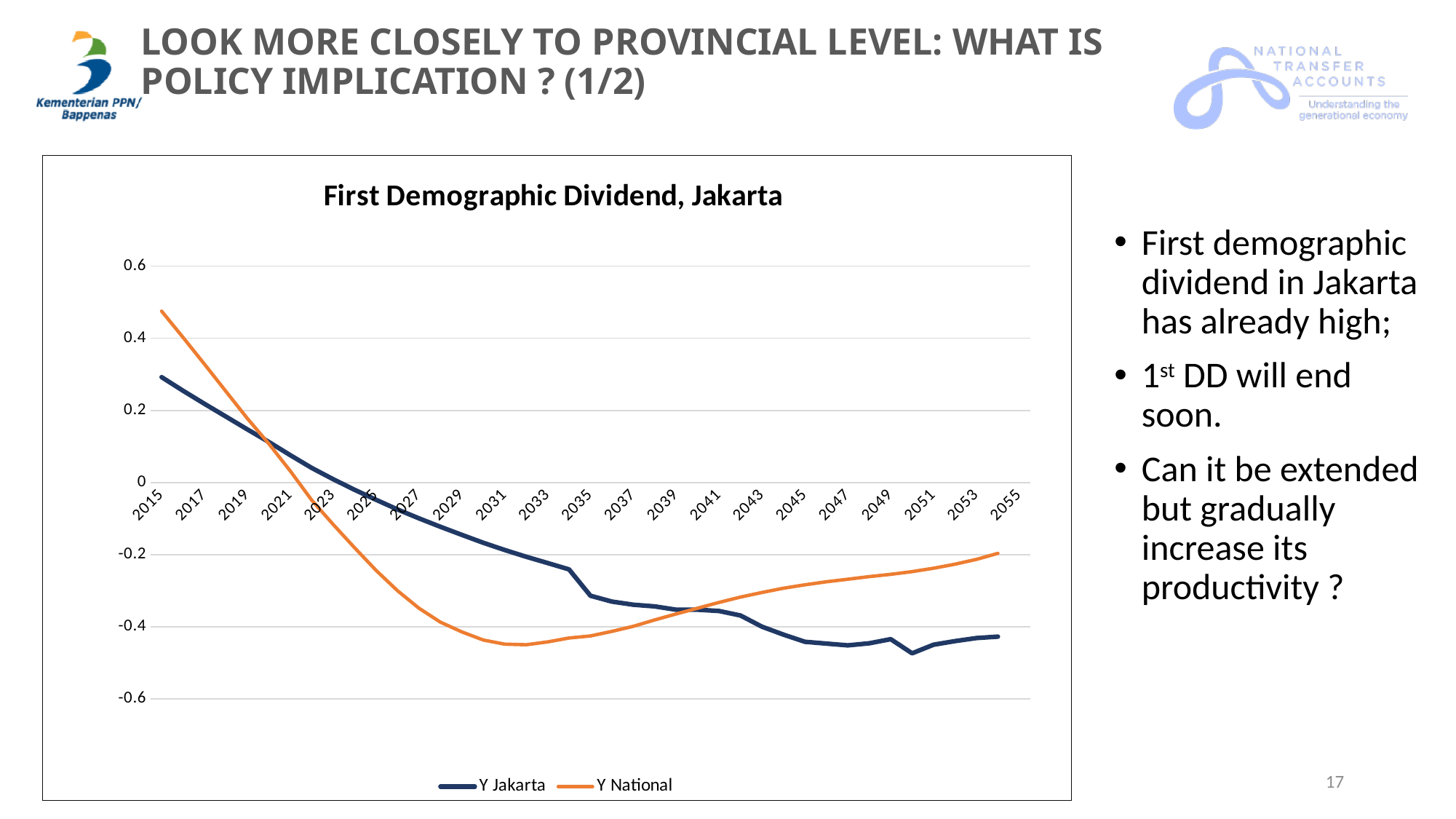
Does the Y Jakarta series overall rise or fall from 2015 to 2055? Fall Is the value for Y National in 2031 greater or less than -0.4? less How many year labels are shown on the x axis? 21 How many series does the chart's legend list? 2 In 2015, which series has the higher value, Y Jakarta or Y National? Y National Is the value for Y Jakarta in 2015 greater or less than 0.2? greater In 2035, which series has the higher value, Y Jakarta or Y National? Y Jakarta What is the title of the chart? First Demographic Dividend, Jakarta Is the value for Y National in 2015 greater or less than 0.4? greater Which series is drawn in orange? Y National What kind of chart is shown on the slide? Line chart